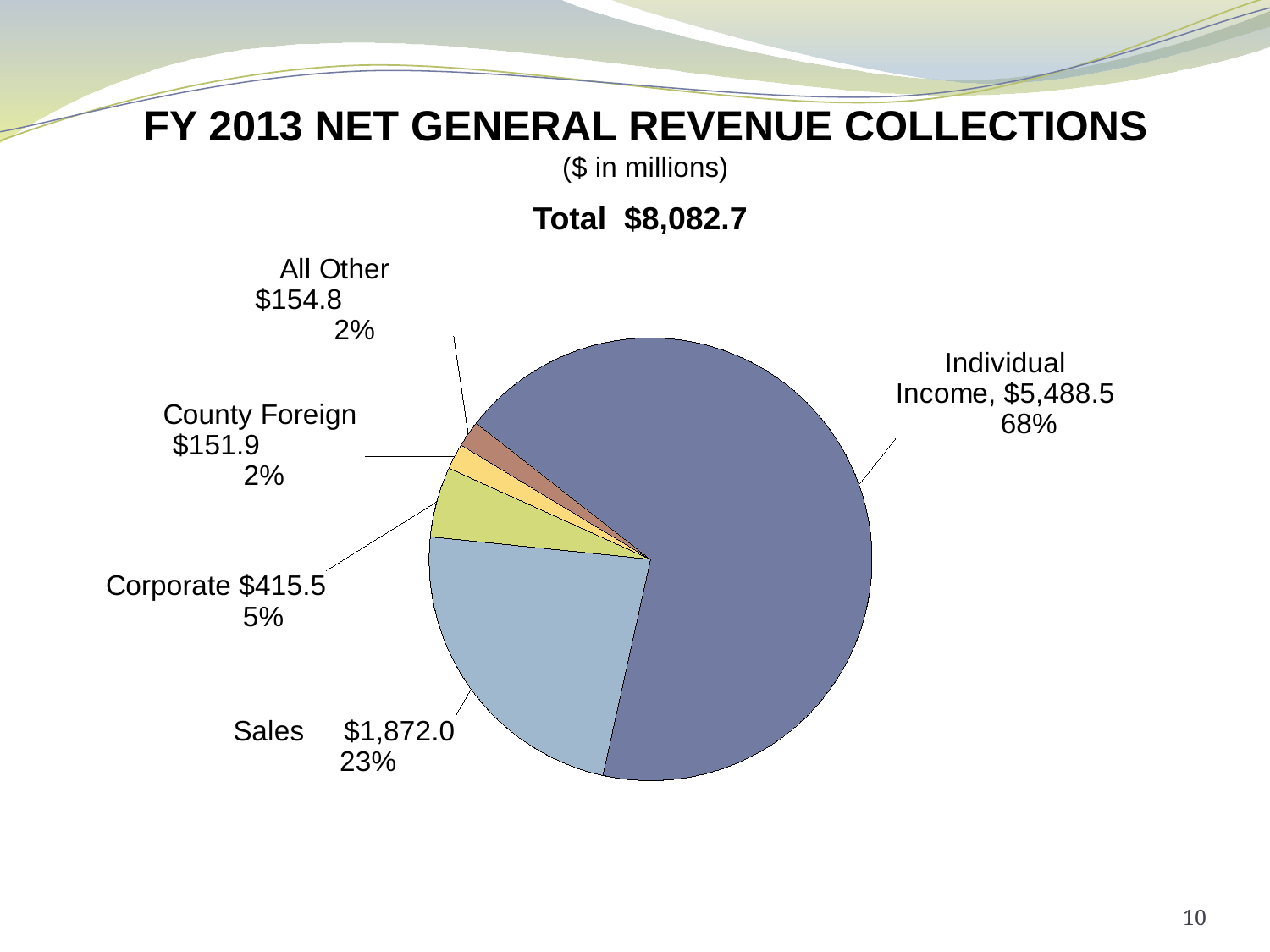
What share of the pie does Sales represent? 23% What type of chart is shown on the slide? pie chart What is the value for Sales? $1,872.0 What is the value for County Foreign? $151.9 What is the difference between the Sales value and the Corporate value? $1,456.5 What is the value for Corporate? $415.5 How many categories are shown in the pie chart? 5 Which category has the smallest slice? County Foreign Which category has the largest slice? Individual Income What is the value for Individual Income? $5,488.5 What share of the pie does Individual Income represent? 68% What total is stated above the pie chart? $8,082.7